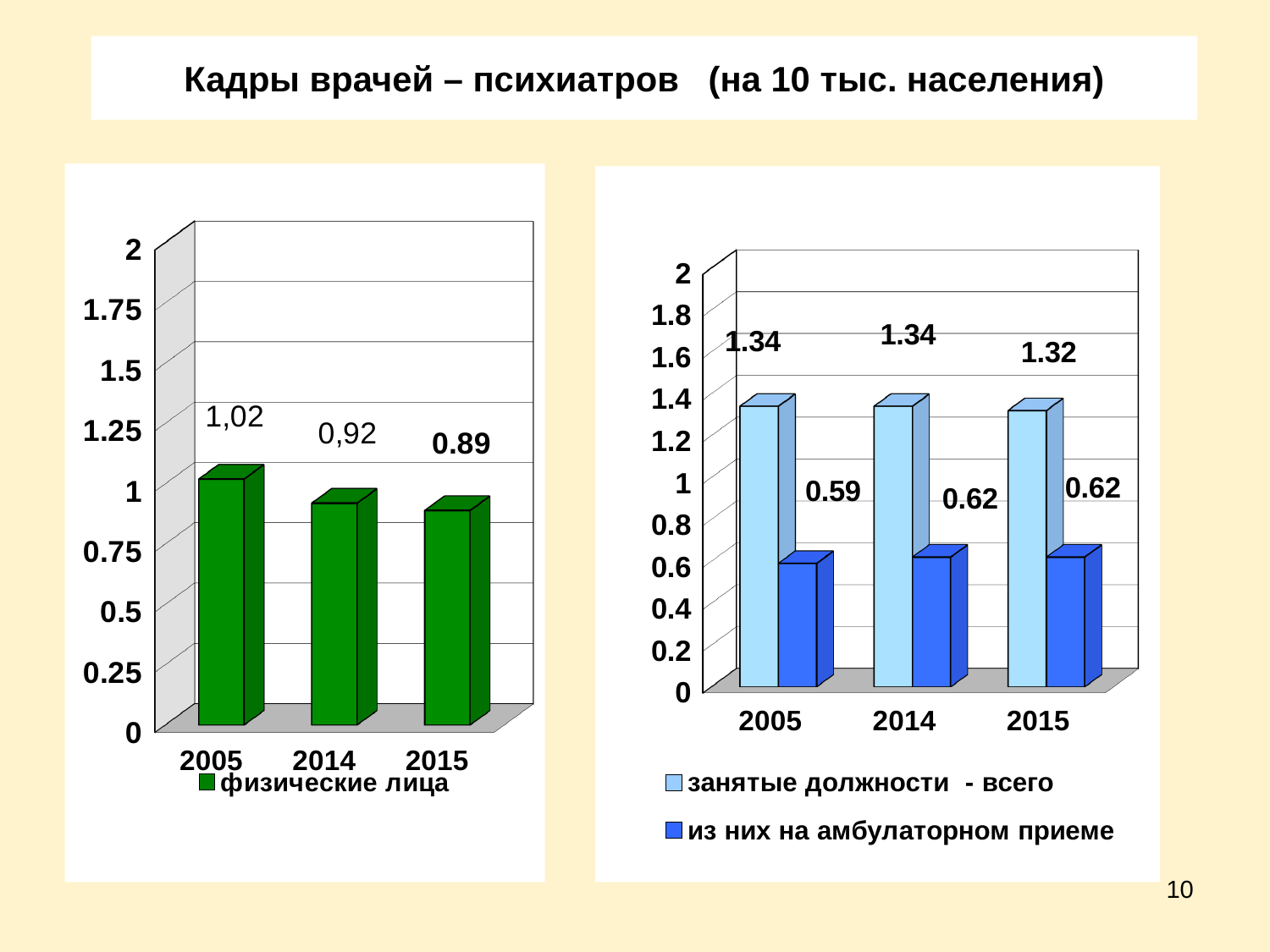
On the right chart, what is the difference between 'занятые должности - всего' and 'из них на амбулаторном приеме' in 2014? 0.72 On the left chart, which year has the highest value? 2005 On the right chart, what is the value of 'занятые должности - всего' for 2015? 1.32 On the left chart, do the values rise or fall from 2005 to 2015? fall On the left chart, what is the value for 2015? 0.89 On the left chart, what is the value for 2005? 1,02 On the left chart, how many years are shown on the x axis? 3 On the left chart, what is the legend entry? физические лица On the right chart, what is the value of 'из них на амбулаторном приеме' for 2005? 0.59 What kind of chart is the right chart? bar chart On the right chart, how many series does the legend list? 2 On the right chart, which is larger in 2005: 'занятые должности - всего' or 'из них на амбулаторном приеме'? занятые должности - всего